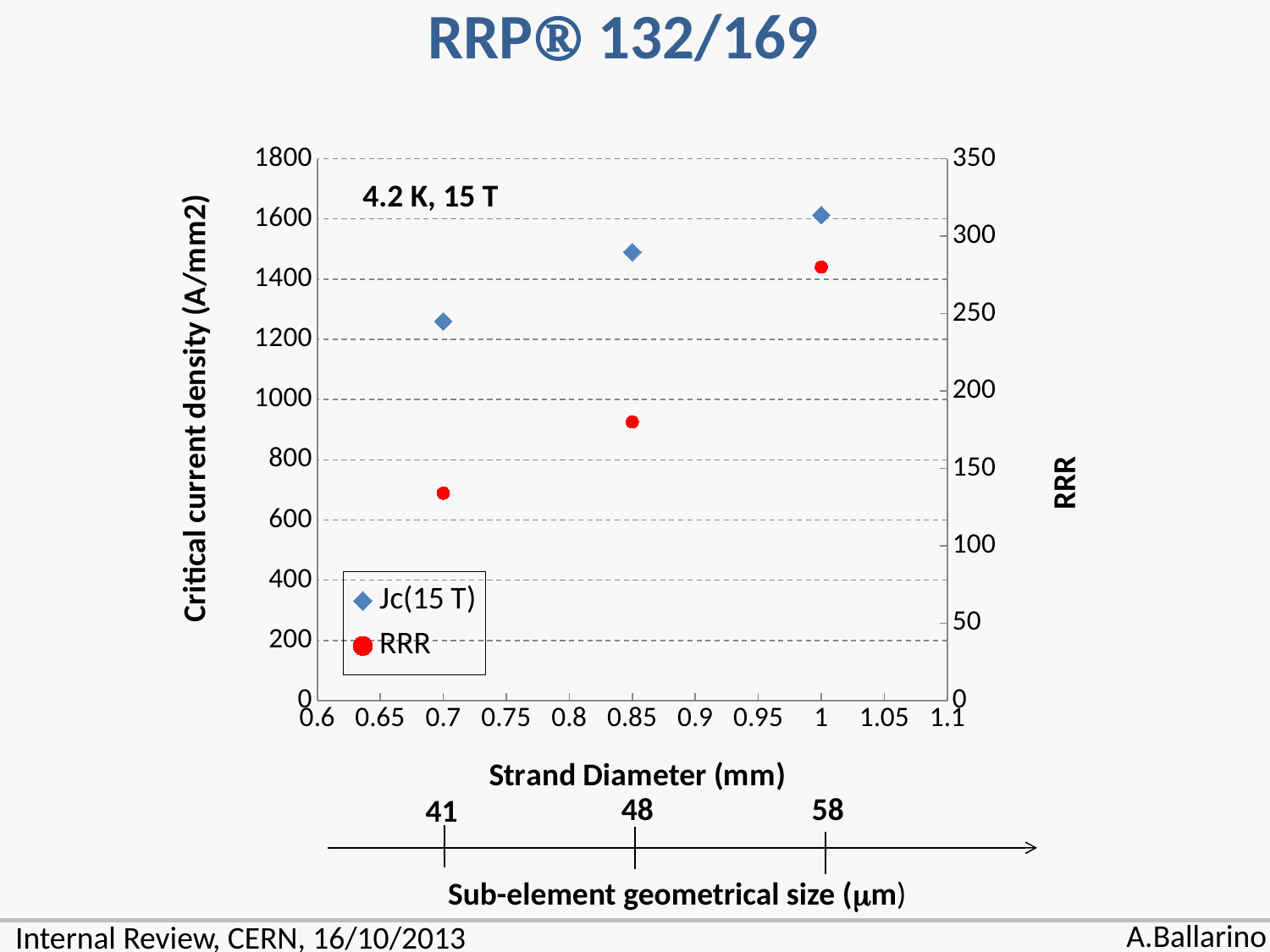
What measurement conditions are annotated inside the plot area? 4.2 K, 15 T At which strand diameter is the Jc(15 T) value highest? 1 mm How many data points are plotted for the Jc(15 T) series? 3 Does the RRR value rise or fall as the strand diameter increases? rise Is the Jc(15 T) value at a strand diameter of 0.7 mm greater or less than 1200? greater What type of chart is shown on the slide? scatter chart How many series does the legend list? 2 Which is larger, the Jc(15 T) value at 0.7 mm or at 1 mm strand diameter? 1 mm Is the Jc(15 T) value at a strand diameter of 0.85 mm greater or less than 1400? greater Is the RRR value at a strand diameter of 0.7 mm greater or less than 150? less At which strand diameter is the RRR value lowest? 0.7 mm